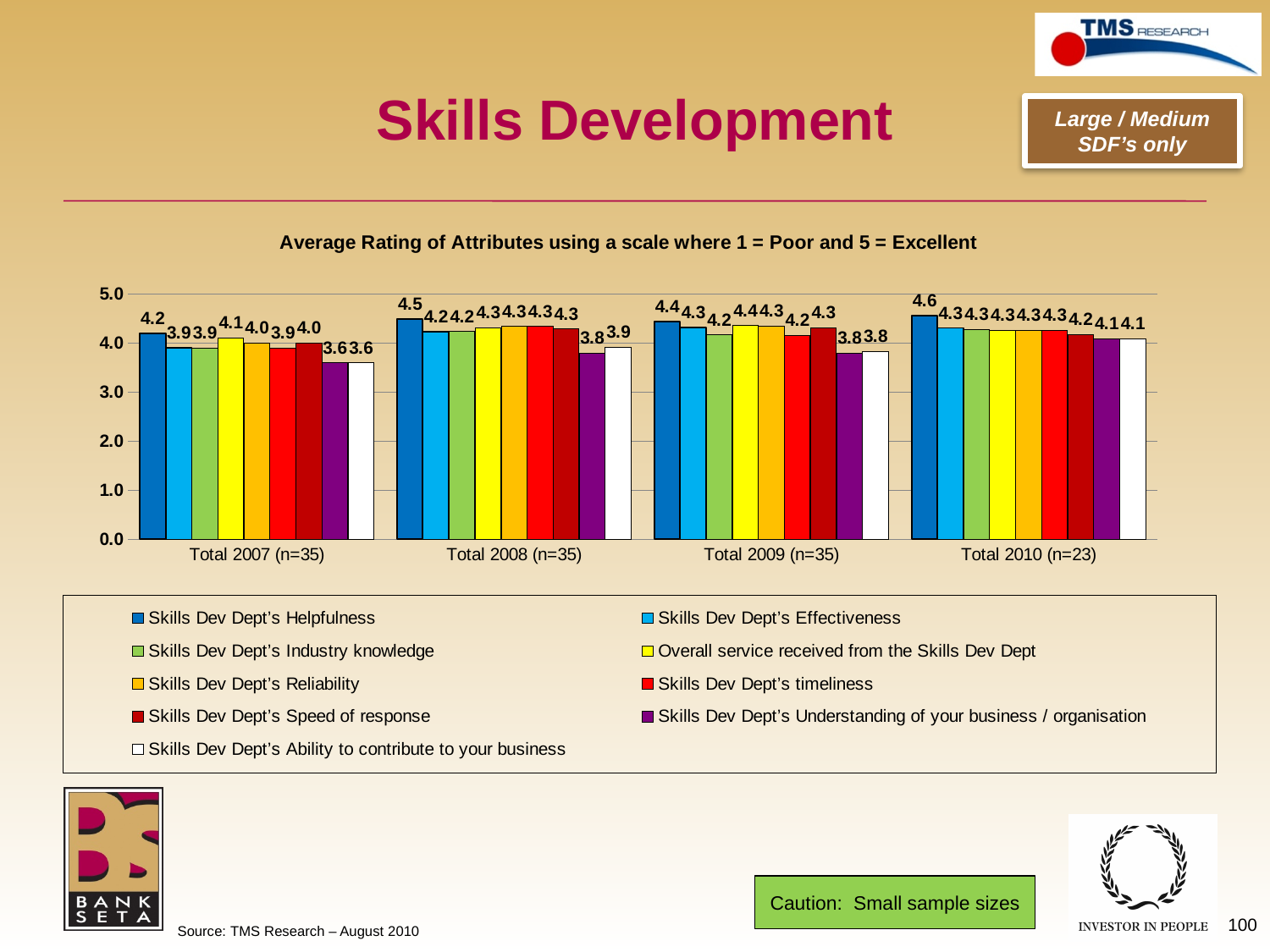
How many series does the legend list? 9 Is the rating for Skills Dev Dept's Understanding of your business / organisation in Total 2010 (n=23) greater or less than 4.0? greater What is the average rating for Skills Dev Dept's Understanding of your business / organisation in Total 2007 (n=35)? 3.6 Which is larger: the Skills Dev Dept's Helpfulness rating in Total 2008 (n=35) or in Total 2009 (n=35)? Total 2008 (n=35) How many year groups are shown on the x axis? 4 What is the sample size (n) for Total 2010? 23 What is the difference between the Skills Dev Dept's Helpfulness rating in Total 2010 (n=23) and in Total 2007 (n=35)? 0.4 What kind of chart is shown on the slide? Bar chart Which attribute has the lowest rating in Total 2008 (n=35)? Skills Dev Dept's Understanding of your business / organisation In which year group is the rating for Skills Dev Dept's Helpfulness the highest? Total 2010 (n=23) What is the average rating for Skills Dev Dept's Helpfulness in Total 2010 (n=23)? 4.6 What is the average rating for Skills Dev Dept's Ability to contribute to your business in Total 2008 (n=35)? 3.9